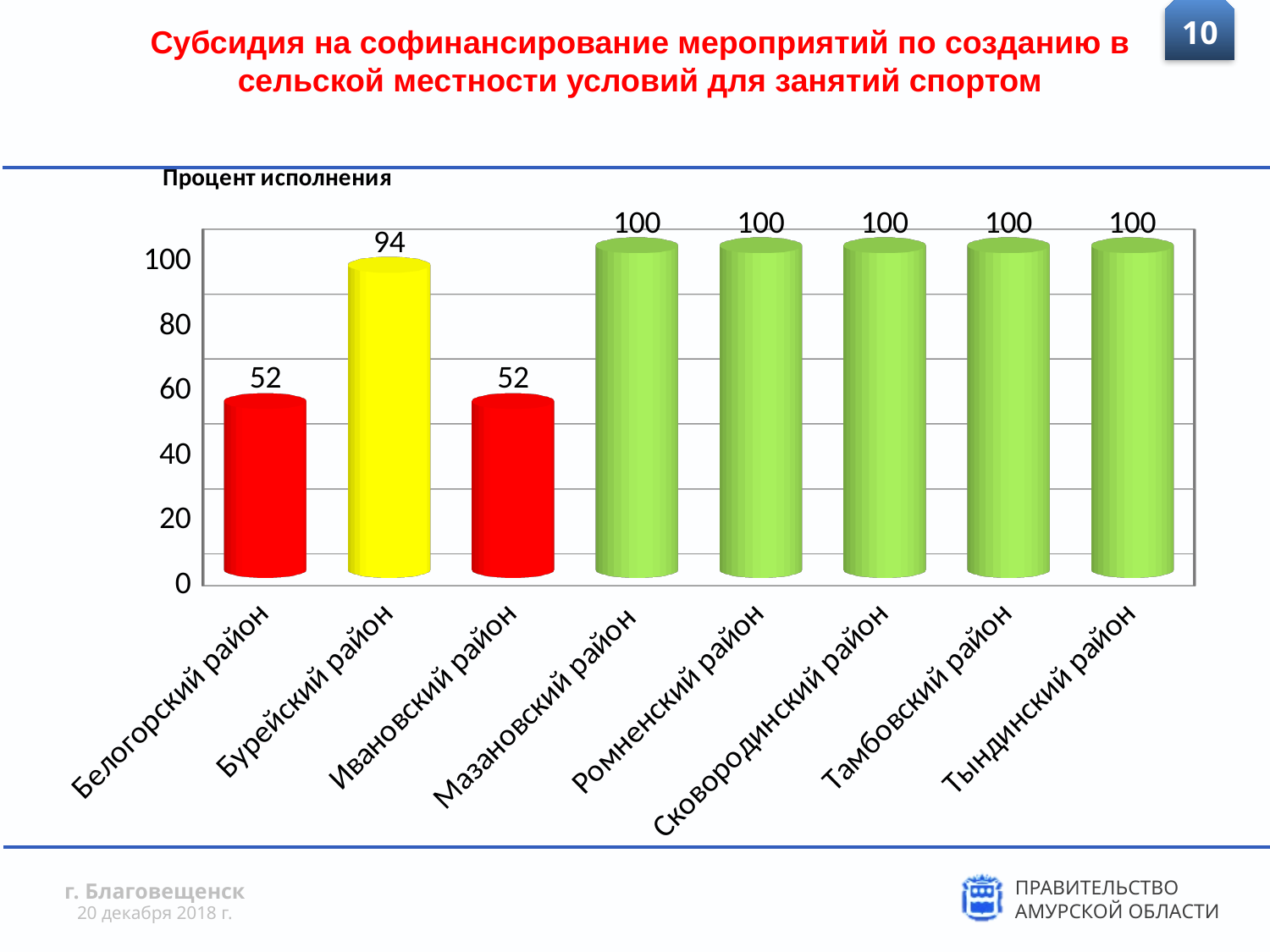
What is the value for Тамбовский район? 100 What is the value for Бурейский район? 94 Which is larger, the value for Бурейский район or the value for Ивановский район? Бурейский район Is the value for Бурейский район greater or less than 80? greater How many categories are shown on the x axis? 8 What kind of chart is shown on the slide? bar chart What is the difference between the values for Бурейский район and Белогорский район? 42 Which category has the highest value? Мазановский район, Ромненский район, Сковородинский район, Тамбовский район, Тындинский район (all 100) Which categories have the lowest value? Белогорский район and Ивановский район What is the title of the chart? Процент исполнения What is the value for Ивановский район? 52 What is the value for Белогорский район? 52